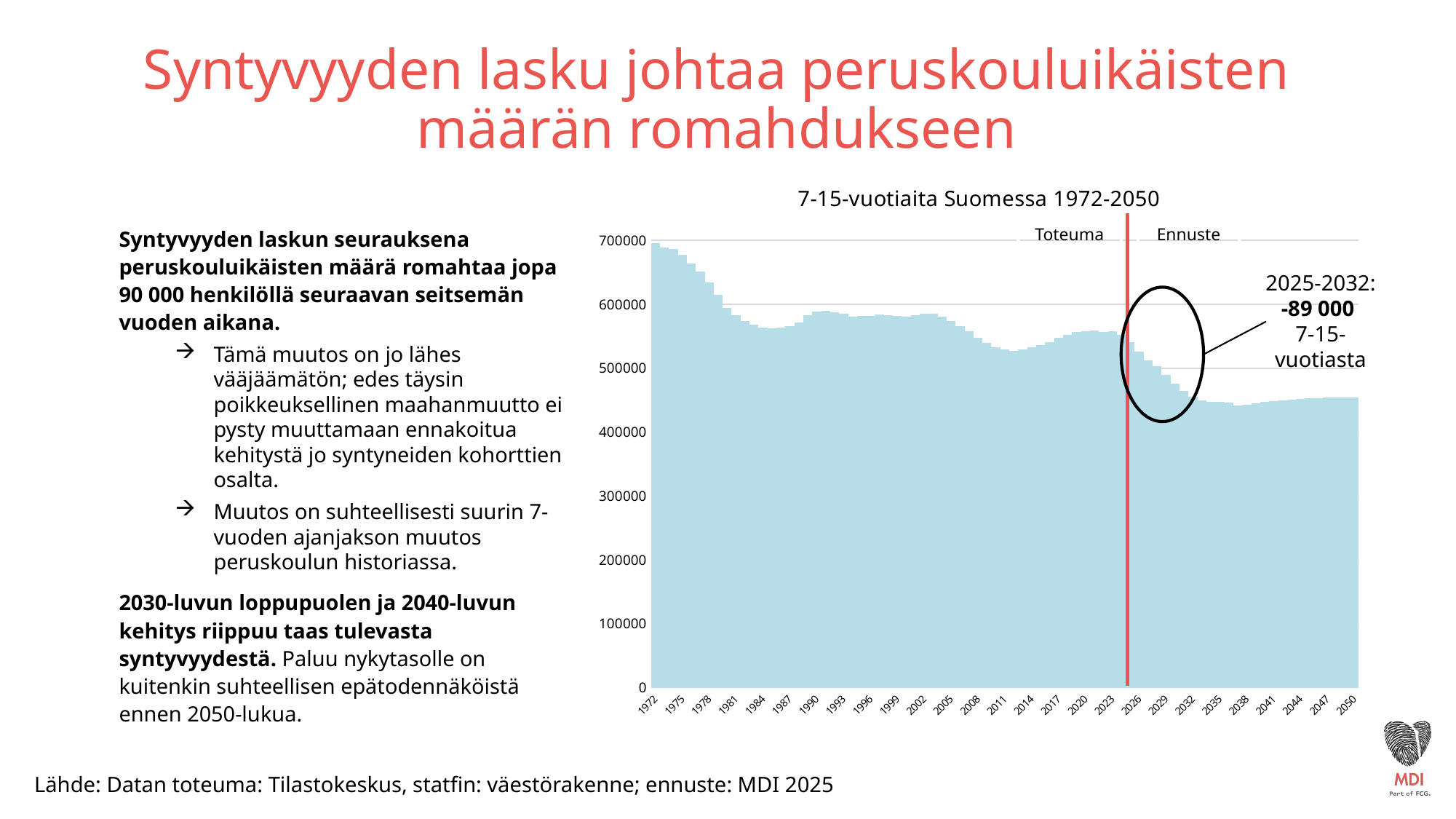
Is the value for 2011 greater or less than 500000? greater Do the values rise or fall between 2023 and 2032? fall Is the value for 1972 greater or less than 600000? greater According to the annotation on the chart, what is the change in the number of 7-15-year-olds between 2025 and 2032? -89 000 What kind of chart is shown on the slide? bar chart What do the two labels on either side of the vertical red line say? Toteuma and Ennuste Which year has the highest value on the chart? 1972 How many year labels are shown on the x axis? 27 Is the value for 2035 greater or less than 500000? less What is the title of the chart? 7-15-vuotiaita Suomessa 1972-2050 Which is larger, the value for 2020 or the value for 2035? 2020